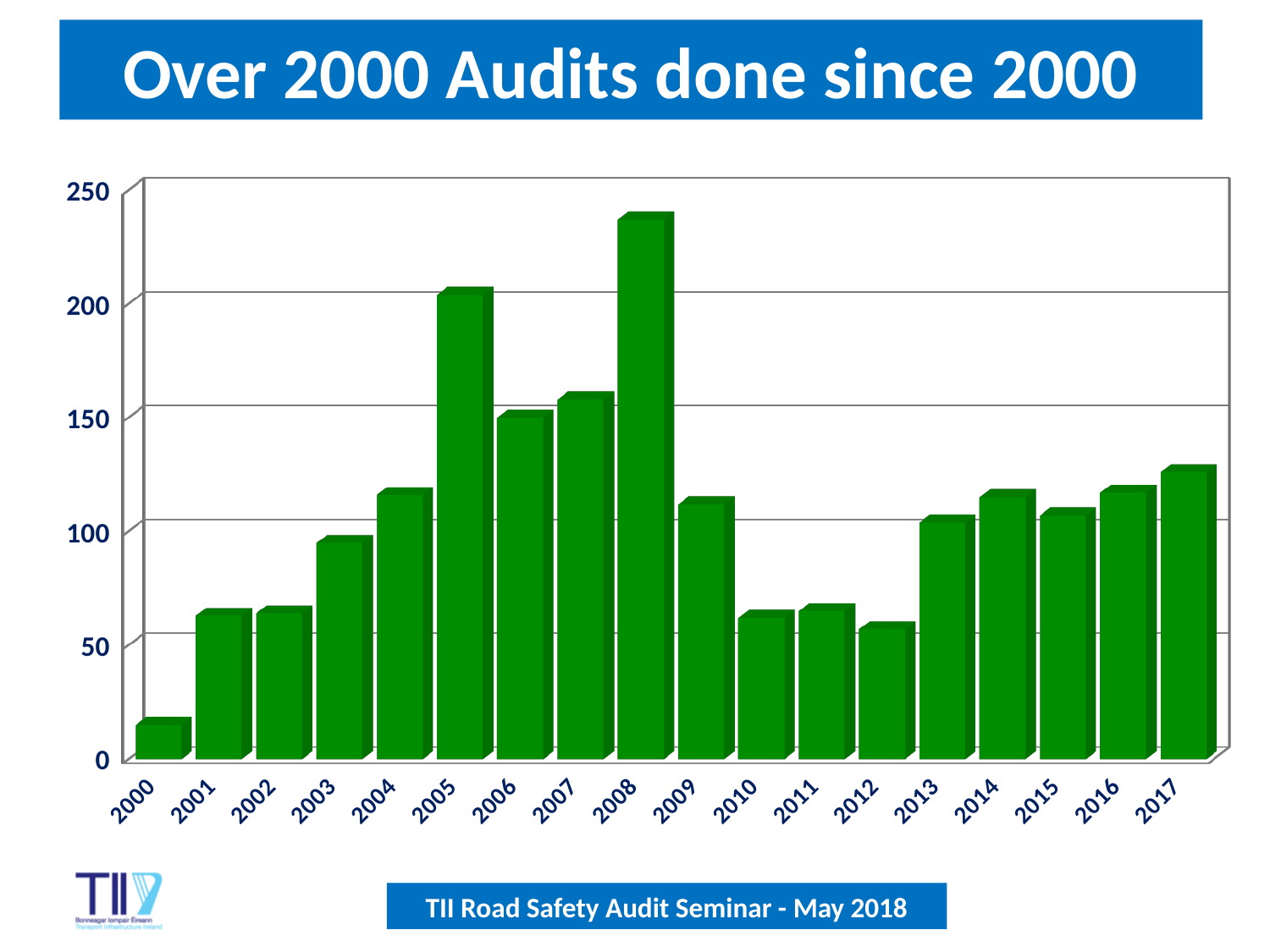
Is the value for 2005 greater or less than 200? greater Do the values rise or fall from 2000 to 2005? rise Is the value for 2003 greater or less than 100? less Is the value for 2000 greater or less than 50? less Which year has the highest number of audits? 2008 What is the title of the chart? Over 2000 Audits done since 2000 Which is larger, the value for 2005 or the value for 2006? 2005 How many years are shown on the x axis? 18 Which year has the lowest number of audits? 2000 What kind of chart is shown on the slide? bar chart